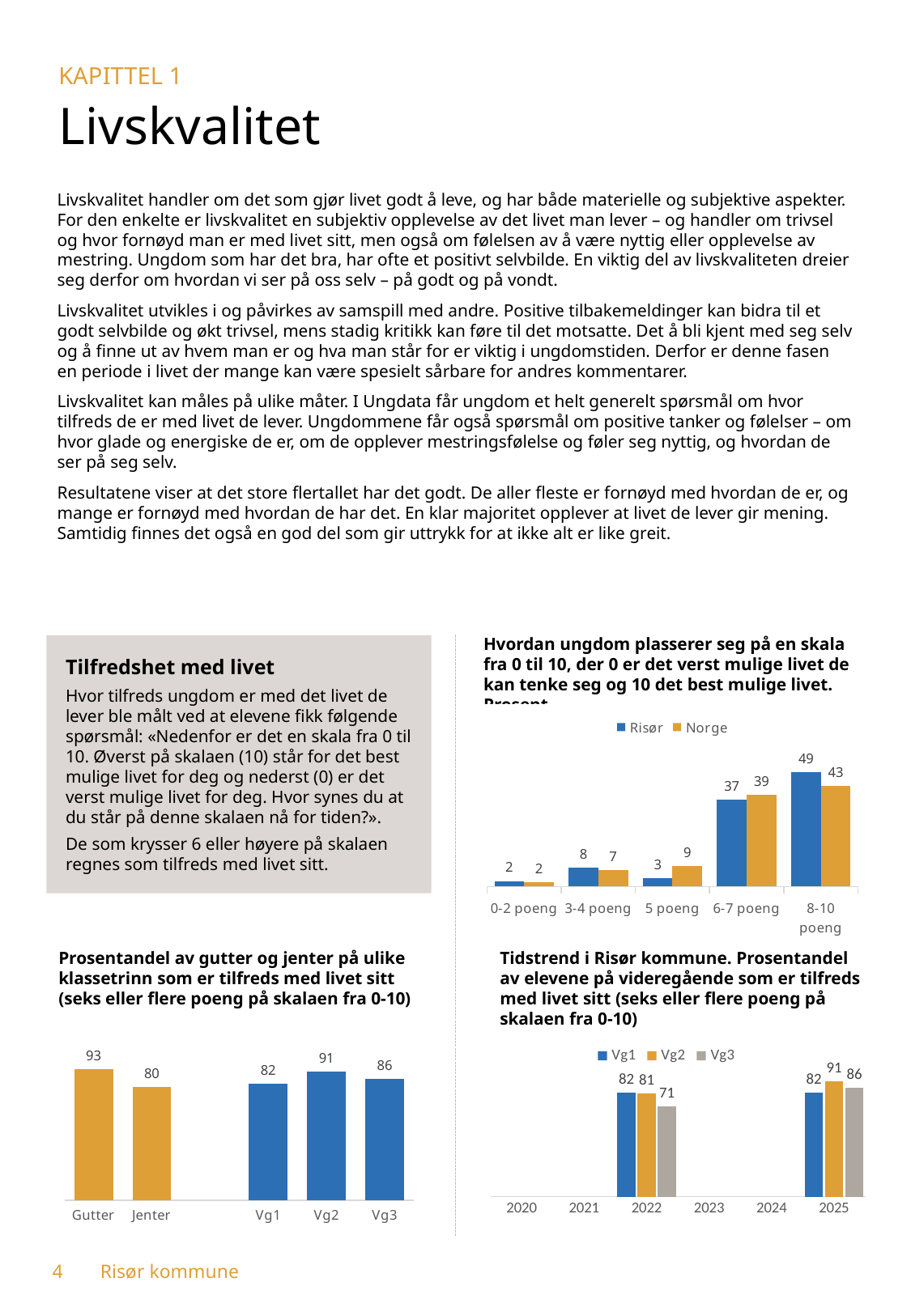
In the top-right chart (Hvordan ungdom plasserer seg på en skala fra 0 til 10), what is the difference between Risør and Norge in the 8-10 poeng category? 6 In the bottom-left chart (Prosentandel av gutter og jenter på ulike klassetrinn som er tilfreds med livet sitt), which category has the lowest value? Jenter In the top-right chart (Hvordan ungdom plasserer seg på en skala fra 0 til 10), what is the value for Norge in the 5 poeng category? 9 In the top-right chart (Hvordan ungdom plasserer seg på en skala fra 0 til 10), which category has the highest value for Risør? 8-10 poeng In the top-right chart (Hvordan ungdom plasserer seg på en skala fra 0 til 10), what is the value for Risør in the 8-10 poeng category? 49 In the bottom-left chart (Prosentandel av gutter og jenter på ulike klassetrinn som er tilfreds med livet sitt), what is the difference between Vg2 and Vg1? 9 In the bottom-left chart (Prosentandel av gutter og jenter på ulike klassetrinn som er tilfreds med livet sitt), what is the value for Gutter? 93 What kind of chart is the bottom-right chart (Tidstrend i Risør kommune)? Bar chart In the bottom-right chart (Tidstrend i Risør kommune), which is larger in 2025: Vg2 or Vg3? Vg2 In the top-right chart (Hvordan ungdom plasserer seg på en skala fra 0 til 10), how many categories are shown on the x axis? 5 In the top-right chart (Hvordan ungdom plasserer seg på en skala fra 0 til 10), how many series does the legend list? 2 In the bottom-right chart (Tidstrend i Risør kommune), what is the value for Vg3 in 2022? 71